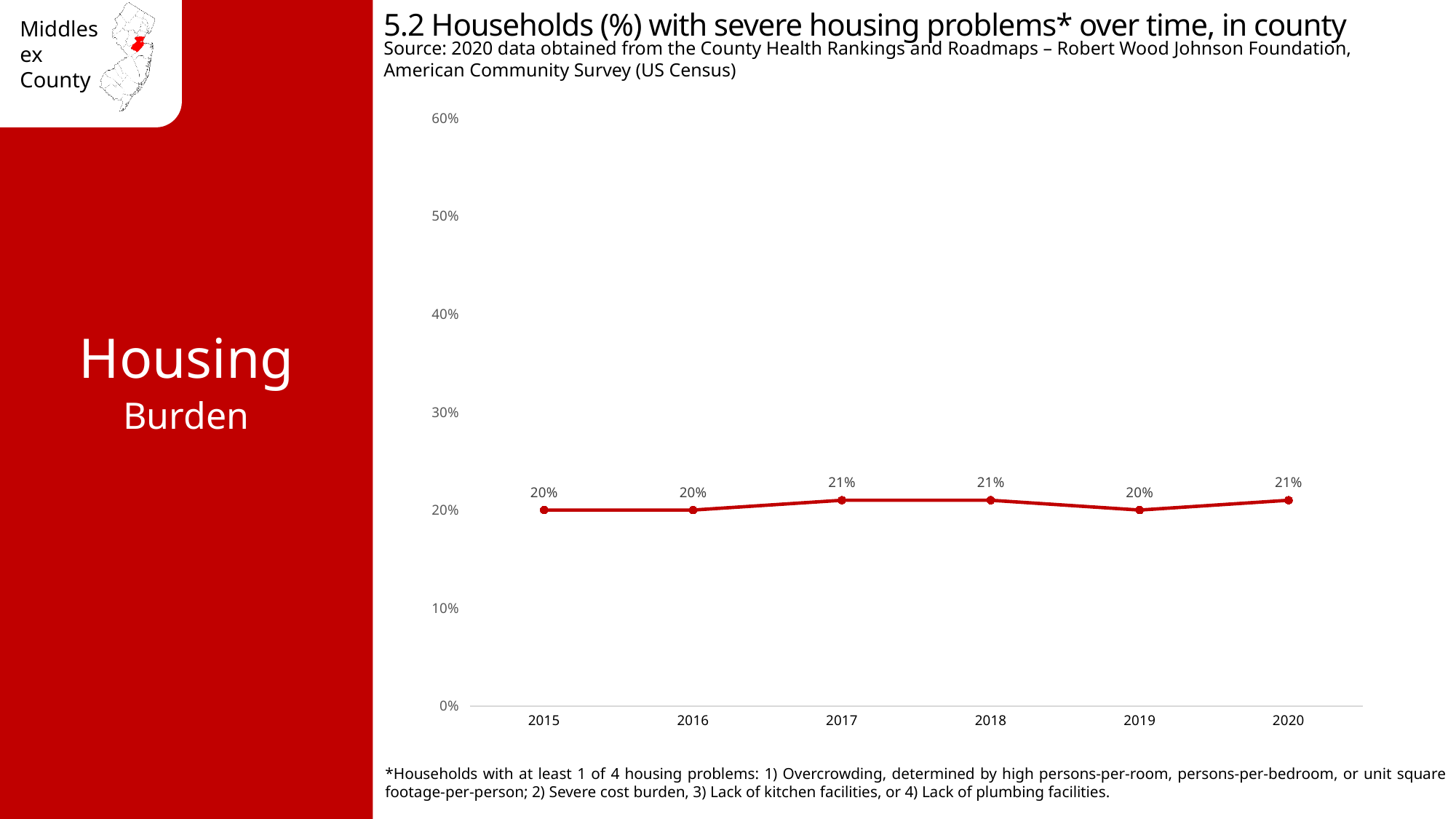
What kind of chart is shown on the slide? line chart What percentage of households had severe housing problems in 2015? 20% What is the difference between the 2017 value and the 2016 value? 1% Is the value for 2020 greater or less than 10%? greater What percentage of households had severe housing problems in 2020? 21% What percentage of households had severe housing problems in 2017? 21% Did the value change between 2015 and 2016? No How many years are plotted on the chart? 6 Is the value for 2018 greater or less than 30%? less What percentage of households had severe housing problems in 2019? 20% Which year is the first on the x axis? 2015 What is the highest value shown on the y axis? 60%